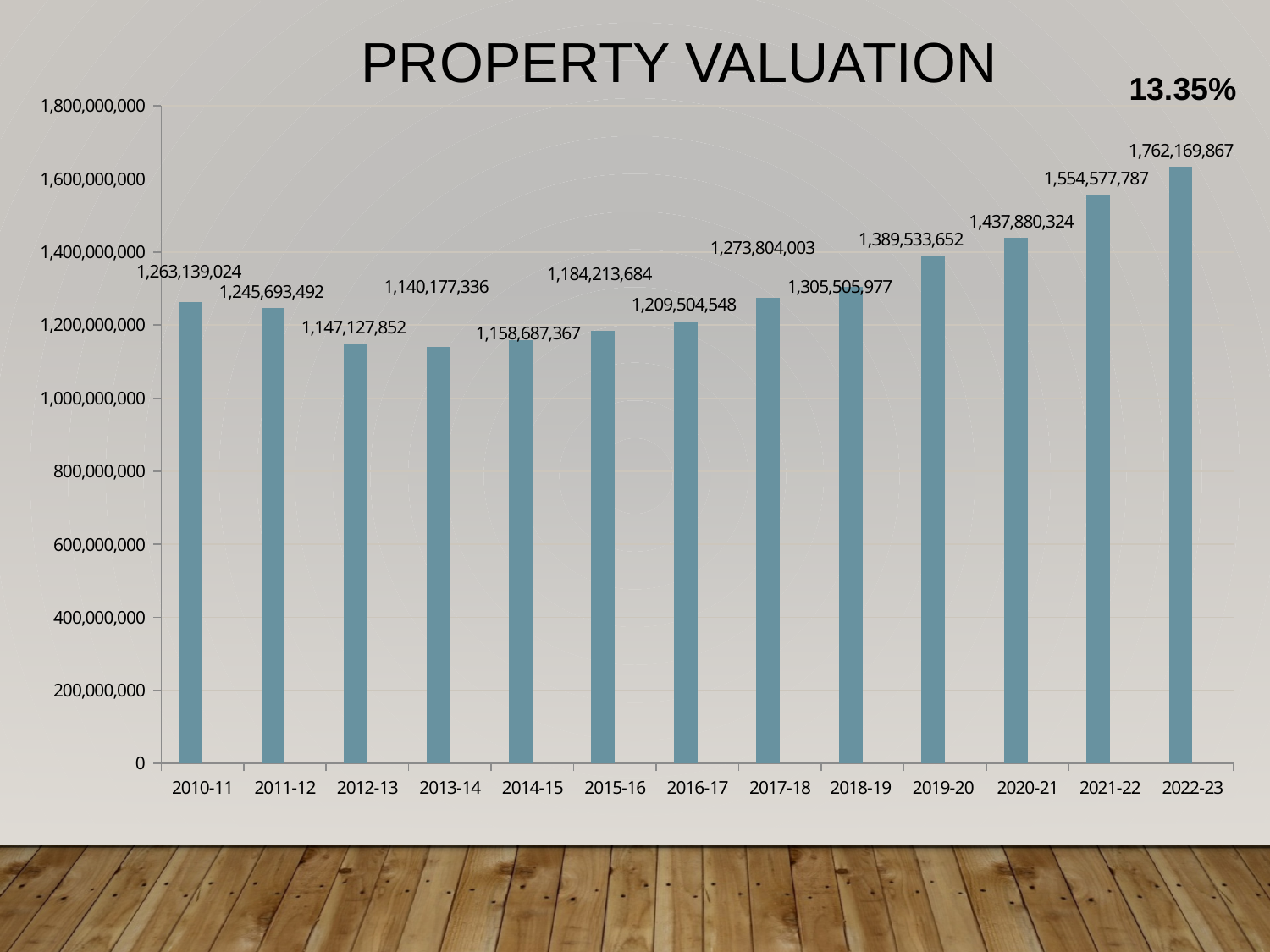
Is the property valuation for 2018-19 greater or less than 1,200,000,000? greater Which year has the lowest property valuation? 2013-14 What is the property valuation for 2013-14? 1,140,177,336 What is the property valuation for 2017-18? 1,273,804,003 What is the difference between the property valuation in 2022-23 and 2021-22? 207,592,080 Do the property valuation values rise or fall from 2013-14 to 2022-23? rise Which year has the highest property valuation? 2022-23 Which is larger, the property valuation in 2010-11 or in 2016-17? 2010-11 What kind of chart is shown on the slide? bar chart What is the difference between the property valuation in 2010-11 and 2011-12? 17,445,532 What is the property valuation for 2022-23? 1,762,169,867 How many years are shown on the chart? 13